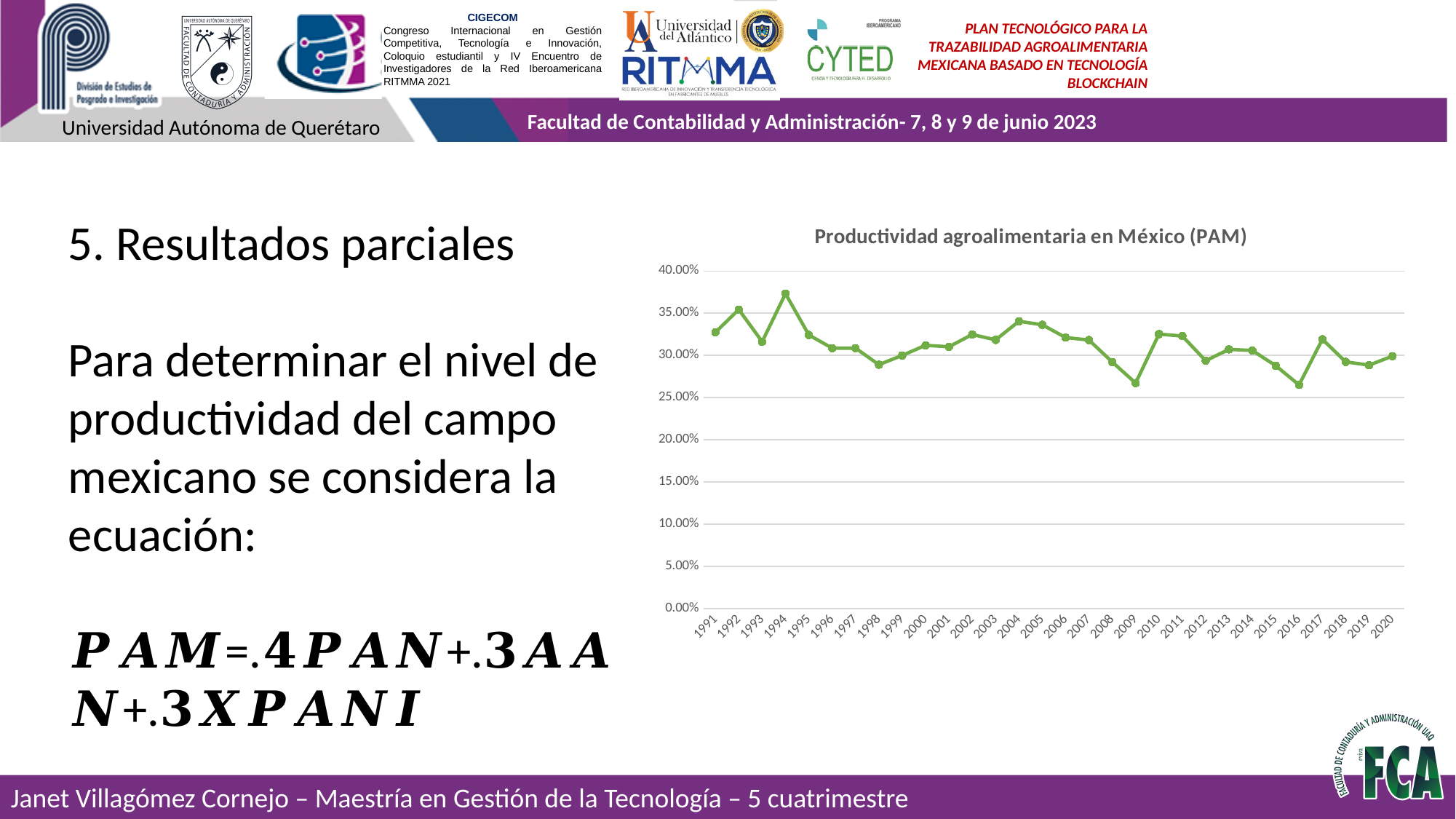
Which year has the larger value, 2009 or 2010? 2010 Which year has the highest value in the chart? 1994 Is the value for 2016 greater or less than 30.00%? less What colour is the line in the chart? green Which year has the larger value, 1992 or 1993? 1992 How many years are plotted on the x axis of the chart? 30 Does the value rise or fall from 1994 to 1998? fall Is the value for 2004 greater or less than 30.00%? greater What type of chart is shown on the slide? line chart Is the value for 2009 greater or less than 30.00%? less What is the title of the chart? Productividad agroalimentaria en México (PAM)